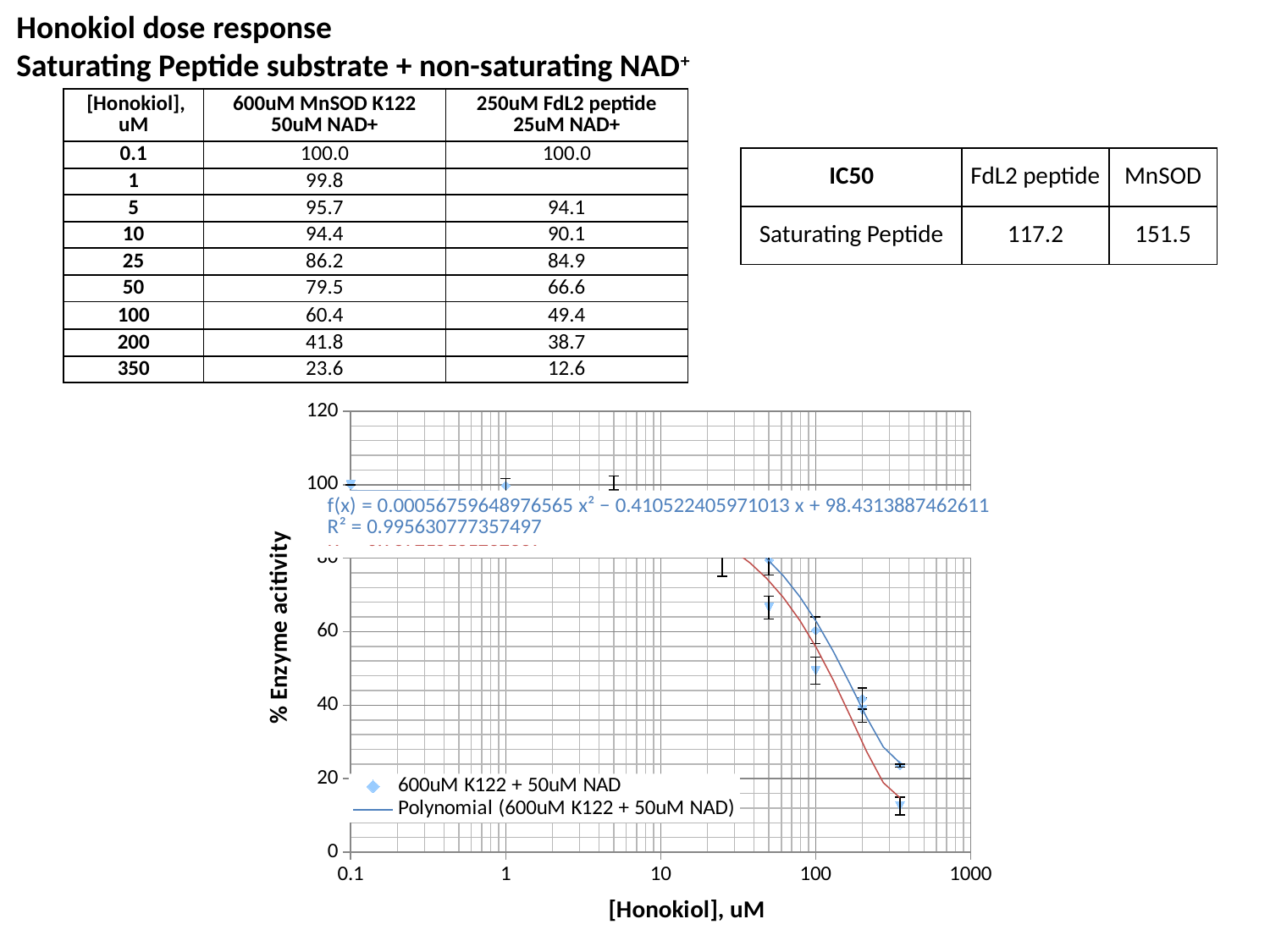
Is the % enzyme activity for the 600uM K122 + 50uM NAD series at 350 uM Honokiol greater or less than 40? less As [Honokiol] increases along the x axis, does % enzyme activity rise or fall? fall What is the title of the x axis of the chart? [Honokiol], uM What R² value is displayed for the polynomial fit on the chart? 0.995630777357497 What is the first series entry listed in the chart legend? 600uM K122 + 50uM NAD According to the data table, what is the % enzyme activity for 250uM FdL2 peptide / 25uM NAD+ at 350 uM Honokiol? 12.6 According to the data table, what is the % enzyme activity for 600uM MnSOD K122 / 50uM NAD+ at 100 uM Honokiol? 60.4 At 350 uM Honokiol, which series has the higher % enzyme activity: 600uM MnSOD K122 / 50uM NAD+ or 250uM FdL2 peptide / 25uM NAD+? 600uM MnSOD K122 / 50uM NAD+ Is the % enzyme activity at 10 uM Honokiol greater or less than 80? greater How many tick labels are shown on the x axis of the chart? 5 What is the highest tick value shown on the y axis of the chart? 120 What kind of chart is shown on the slide? scatter chart